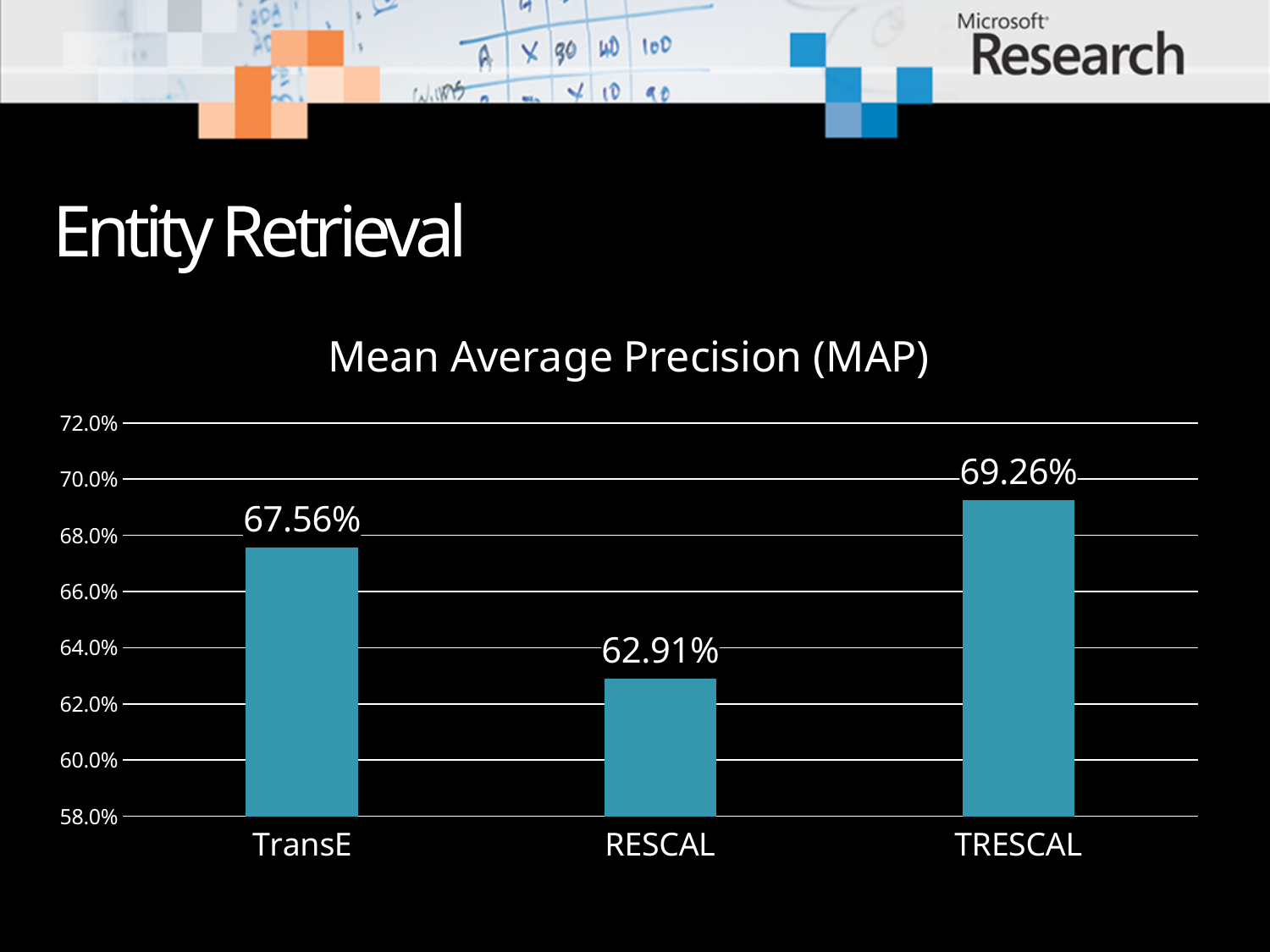
What kind of chart is shown on the slide? bar chart What is the difference in MAP between TRESCAL and RESCAL? 6.35% What is the MAP value for TRESCAL? 69.26% What is the MAP value for TransE? 67.56% Is the MAP value for RESCAL greater or less than 64.0%? less Which method has the highest MAP? TRESCAL What is the difference in MAP between TRESCAL and TransE? 1.70% What is the title of the chart? Mean Average Precision (MAP) Which has a higher MAP, TransE or RESCAL? TransE What is the MAP value for RESCAL? 62.91% How many methods are compared in the chart? 3 Which method has the lowest MAP? RESCAL